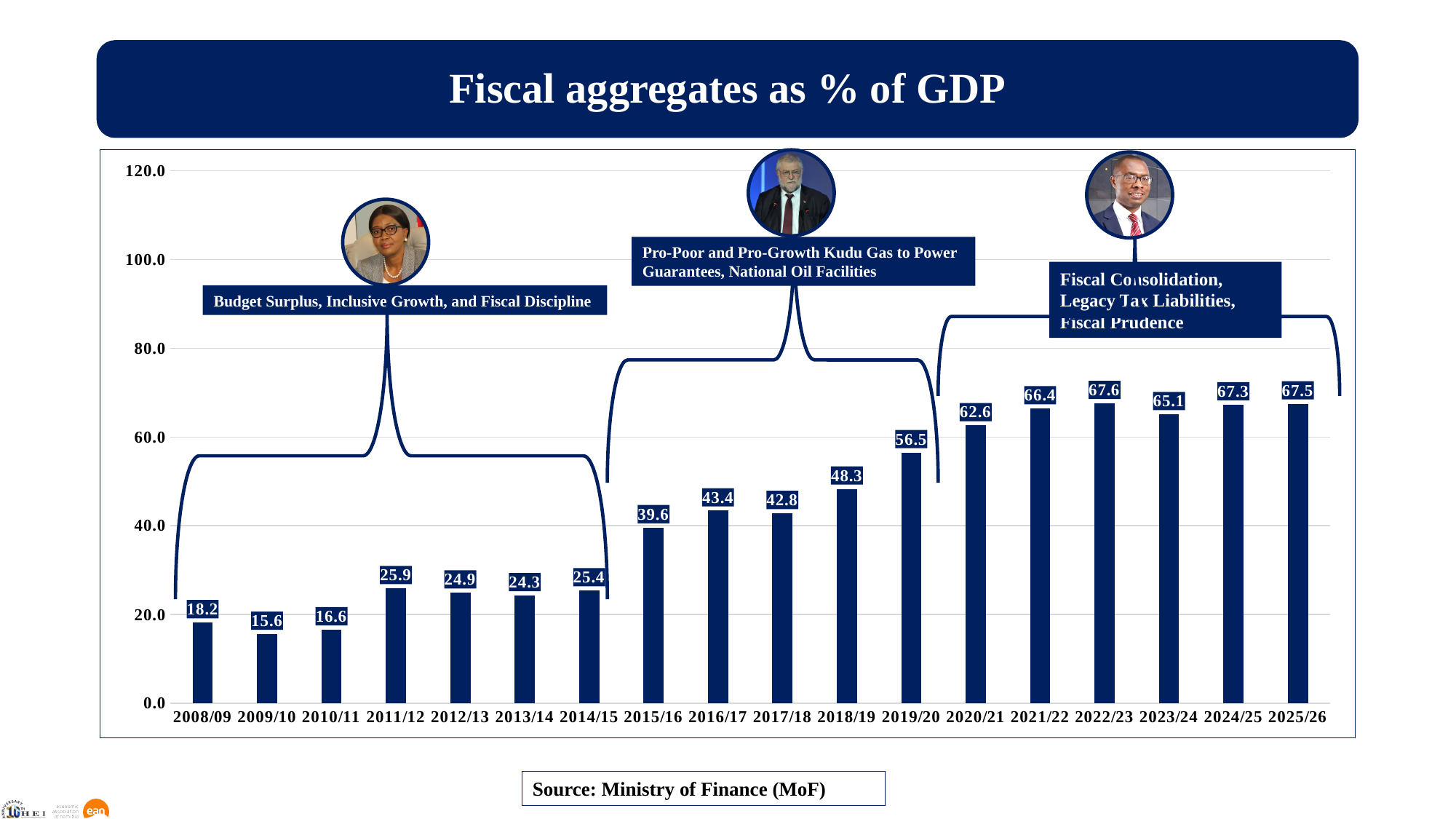
What is the title of the chart? Fiscal aggregates as % of GDP Which is larger, the value for 2016/17 or the value for 2017/18? 2016/17 What is the difference between the values for 2015/16 and 2014/15? 14.2 What is the value for 2025/26? 67.5 Which fiscal year has the lowest value? 2009/10 What is the value for 2019/20? 56.5 How many fiscal years are shown on the x axis? 18 What is the value for 2008/09? 18.2 Which fiscal year has the highest value? 2022/23 What kind of chart is shown on the slide? Bar chart Is the value for 2018/19 greater or less than 40.0? greater Do the values generally rise or fall from 2008/09 to 2025/26? Rise